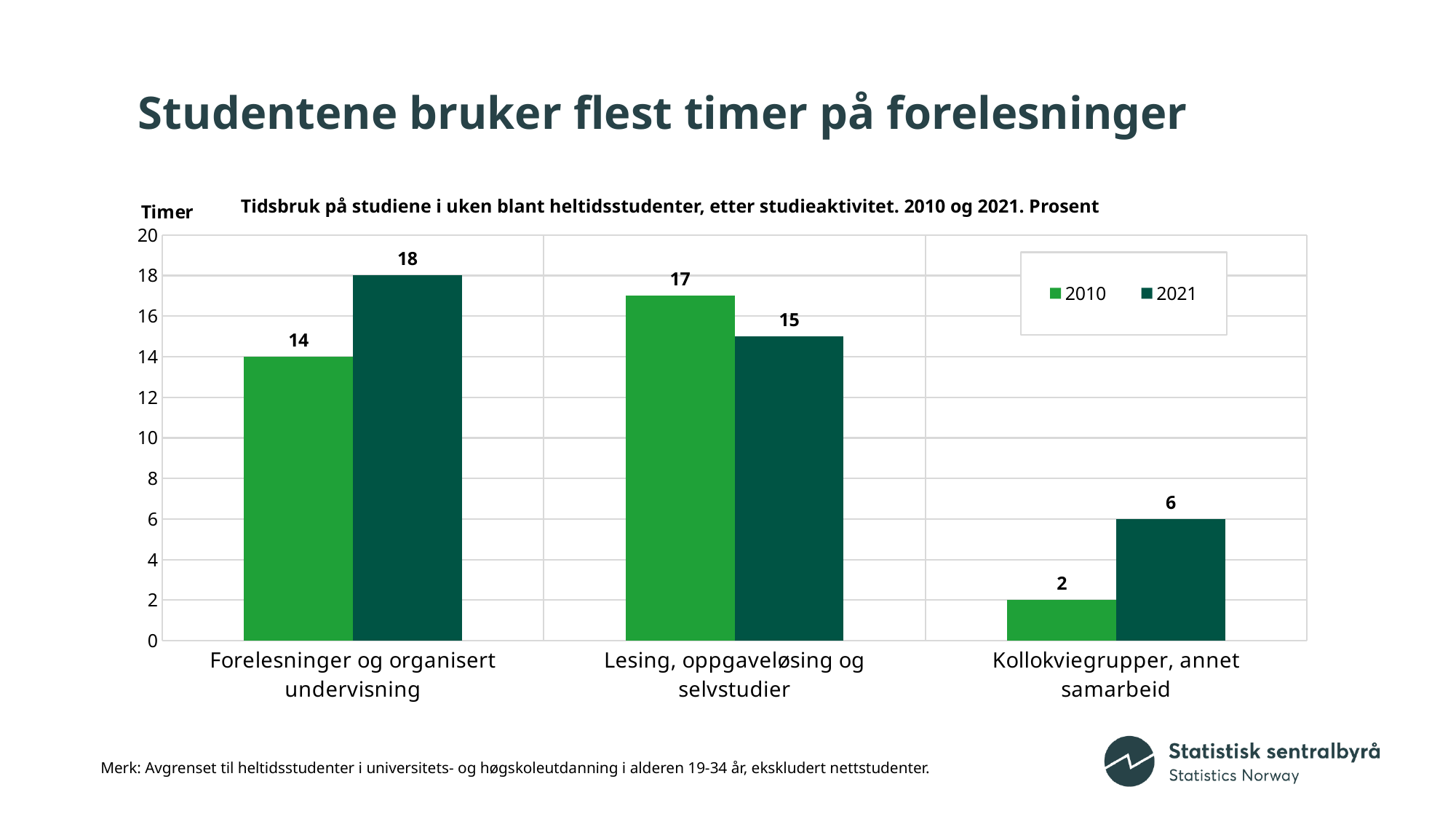
What is the difference between the 2021 and 2010 values for 'Forelesninger og organisert undervisning'? 4 Which is larger for 'Lesing, oppgaveløsing og selvstudier': the 2010 value or the 2021 value? 2010 What kind of chart is shown on the slide? Bar chart How many series does the legend list? 2 Is the 2021 value for 'Kollokviegrupper, annet samarbeid' greater or less than 10? less How many categories are shown on the x axis? 3 What unit label is shown above the y axis? Timer What is the value for 'Lesing, oppgaveløsing og selvstudier' in 2010? 17 What is the value for 'Forelesninger og organisert undervisning' in 2021? 18 What is the value for 'Kollokviegrupper, annet samarbeid' in 2010? 2 Which category has the lowest value in the 2010 series? Kollokviegrupper, annet samarbeid Which category has the highest value in the 2021 series? Forelesninger og organisert undervisning